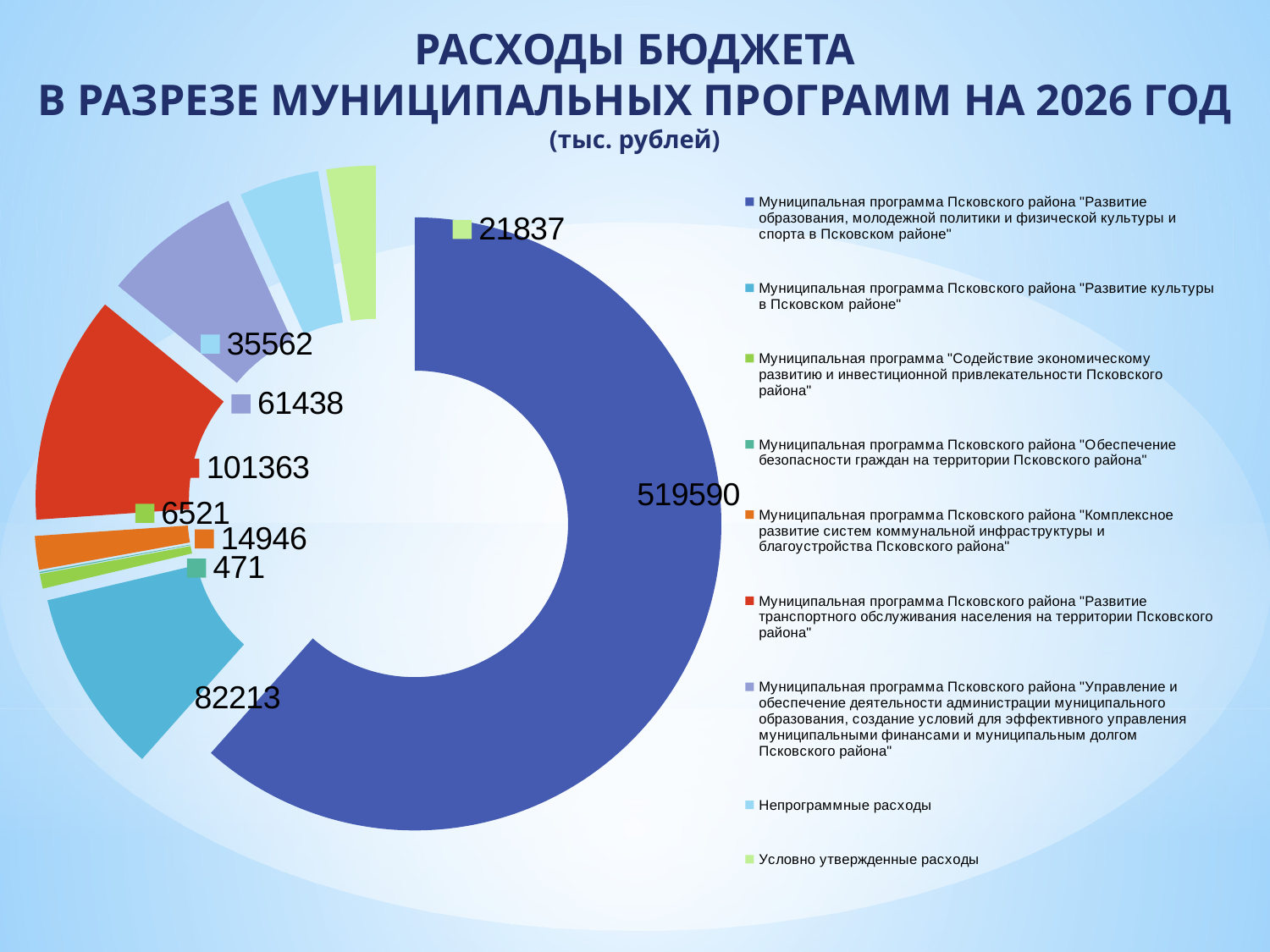
What is the value for "Условно утвержденные расходы"? 21837 What is the value for the municipal program "Развитие транспортного обслуживания населения на территории Псковского района"? 101363 What is the value for "Непрограммные расходы"? 35562 What is the value for the municipal program "Развитие образования, молодежной политики и физической культуры и спорта в Псковском районе"? 519590 Which category has the smallest value? Муниципальная программа Псковского района "Обеспечение безопасности граждан на территории Псковского района" (471) What is the value for the municipal program "Развитие культуры в Псковском районе"? 82213 Which is larger: the value for the communal infrastructure program or the value for the economic development program? Communal infrastructure program (14946) What type of chart is shown on the slide? Doughnut (pie) chart Which category has the largest value? Муниципальная программа Псковского района "Развитие образования, молодежной политики и физической культуры и спорта в Псковском районе" (519590) In what units are the values on the chart given, according to the title? тыс. рублей What is the difference between the transport program (101363) and the culture program (82213)? 19150 How many categories does the chart show? 9